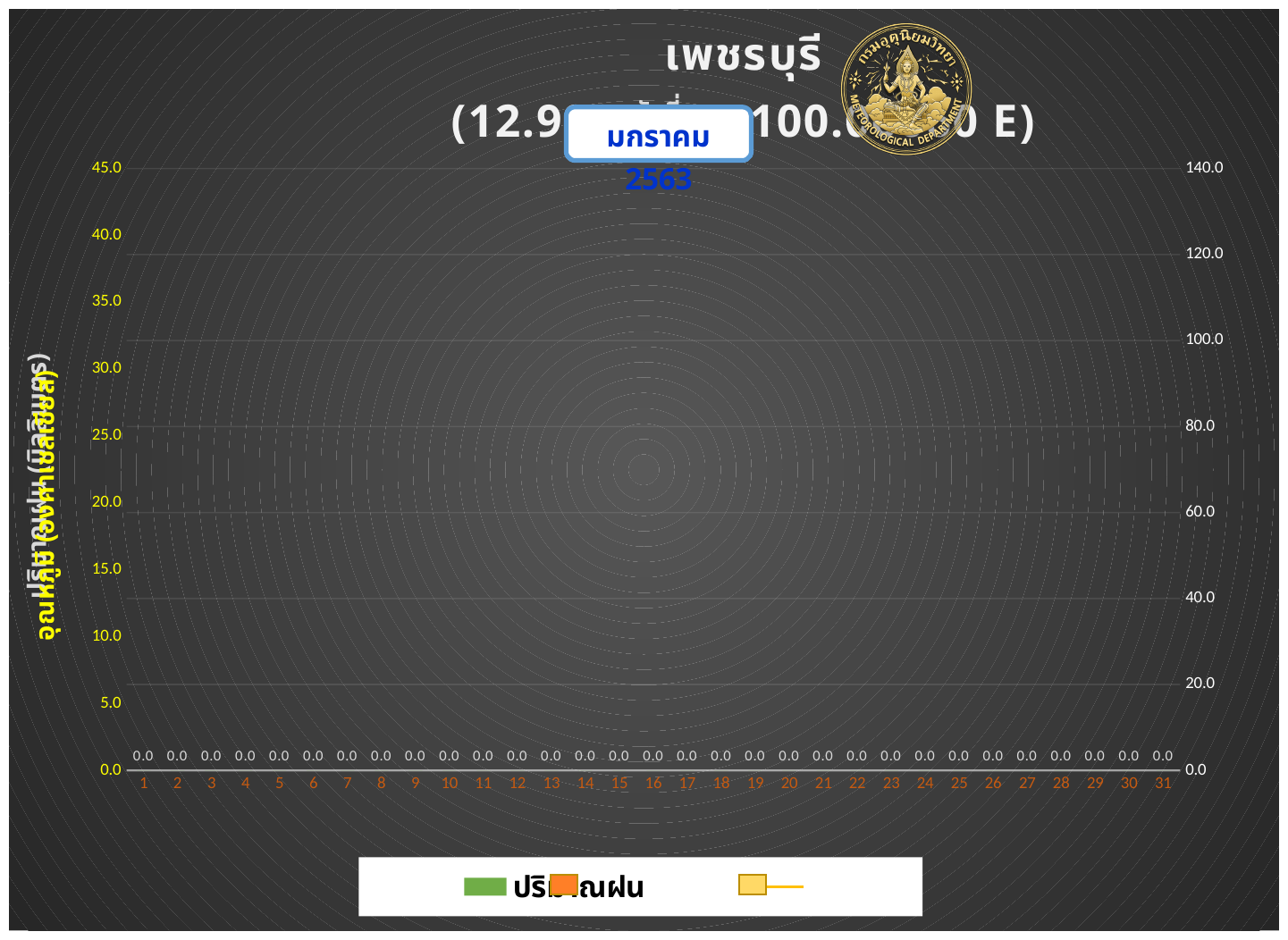
What is the data label shown for day 31 on the chart? 0.0 What is the data label shown for day 15 on the chart? 0.0 Is the value for day 7 greater or less than 5.0 on the left axis? less What is the data label shown for day 1 on the chart? 0.0 What is the total of the values for days 1 through 5? 0.0 Do the plotted values rise, fall, or stay flat from day 1 to day 31? stay flat What is the highest tick value shown on the left vertical axis? 45.0 What is the highest tick value shown on the right vertical axis? 140.0 What is the difference between the values for day 10 and day 20? 0.0 How many days (categories) are shown along the x axis of the chart? 31